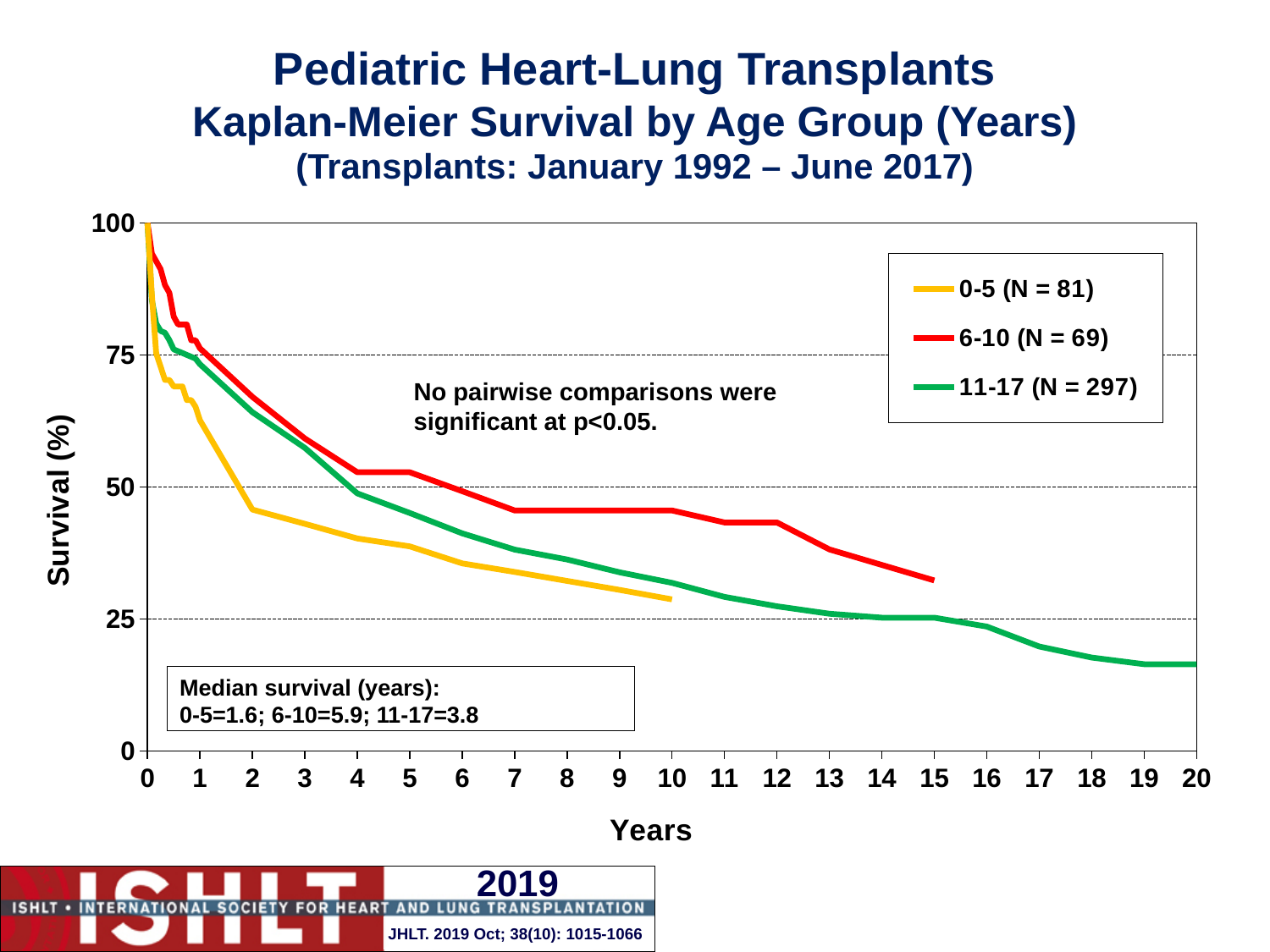
What is the N for the 11-17 age group? 297 At 10 years, which group has higher survival, 6-10 or 11-17? 6-10 Is the survival for the 0-5 group at 5 years greater or less than 50%? less Which age group has the largest number of transplants (N)? 11-17 Do the survival curves rise or fall as years increase? fall What kind of chart is shown on the slide? line chart What is the median survival in years for the 6-10 age group? 5.9 How many age groups does the legend list? 3 Which age group has the highest median survival? 6-10 Which age group has the lowest median survival? 0-5 Is the survival for the 11-17 group at 20 years greater or less than 25%? less Is the survival for the 6-10 group at 5 years greater or less than 50%? greater